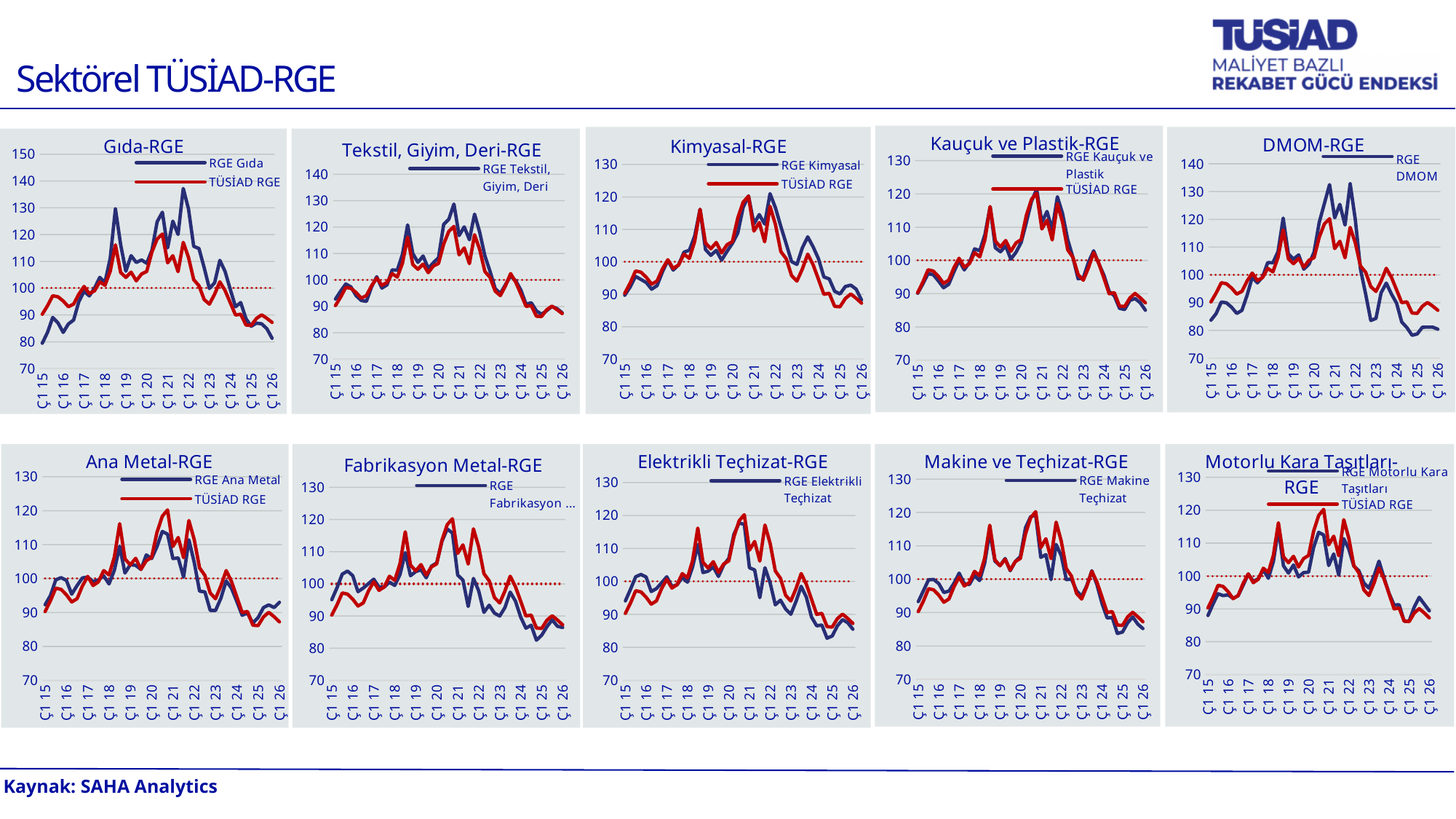
In the Fabrikasyon Metal-RGE chart, is the value of the RGE Fabrikasyon series at Ç1 25 greater or less than 90? less In the Gıda-RGE chart, is the peak value of the RGE Gıda series greater or less than 130? greater How many series does the legend of the Gıda-RGE chart list? 2 What kind of chart is the Gıda-RGE chart? line chart In the Gıda-RGE chart, does the RGE Gıda series rise or fall from Ç1 22 to Ç1 26? fall In the Kimyasal-RGE chart, is the value of RGE Kimyasal at Ç1 15 greater or less than 100? less How many charts are shown on the slide? 10 What are the two legend entries of the Ana Metal-RGE chart? RGE Ana Metal and TÜSİAD RGE In the Elektrikli Teçhizat-RGE chart, which series is higher at Ç1 22, RGE Elektrikli Teçhizat or TÜSİAD RGE? TÜSİAD RGE